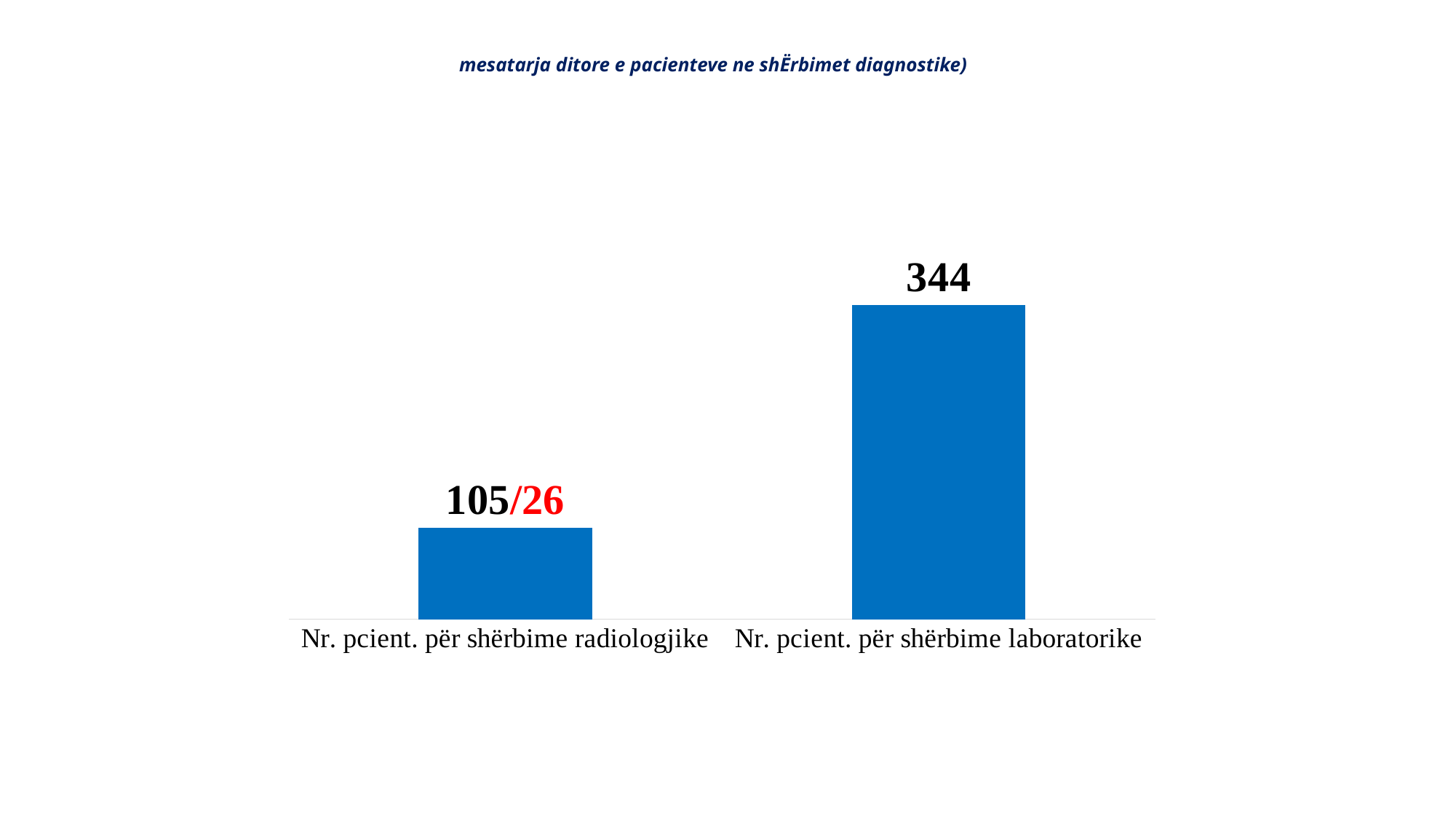
What kind of chart is shown on the slide? Bar chart What data label is shown on the bar for "Nr. pcient. për shërbime radiologjike"? 105/26 Which category has the lowest bar? Nr. pcient. për shërbime radiologjike How many categories are plotted in the chart? 2 Do the bar values rise or fall from left to right? Rise Which category has the highest bar? Nr. pcient. për shërbime laboratorike In the data label "105/26", what colour is the number 26 printed in? Red Which bar is taller: "Nr. pcient. për shërbime radiologjike" or "Nr. pcient. për shërbime laboratorike"? Nr. pcient. për shërbime laboratorike What colour are the bars in the chart? Blue What data label is shown on the bar for "Nr. pcient. për shërbime laboratorike"? 344